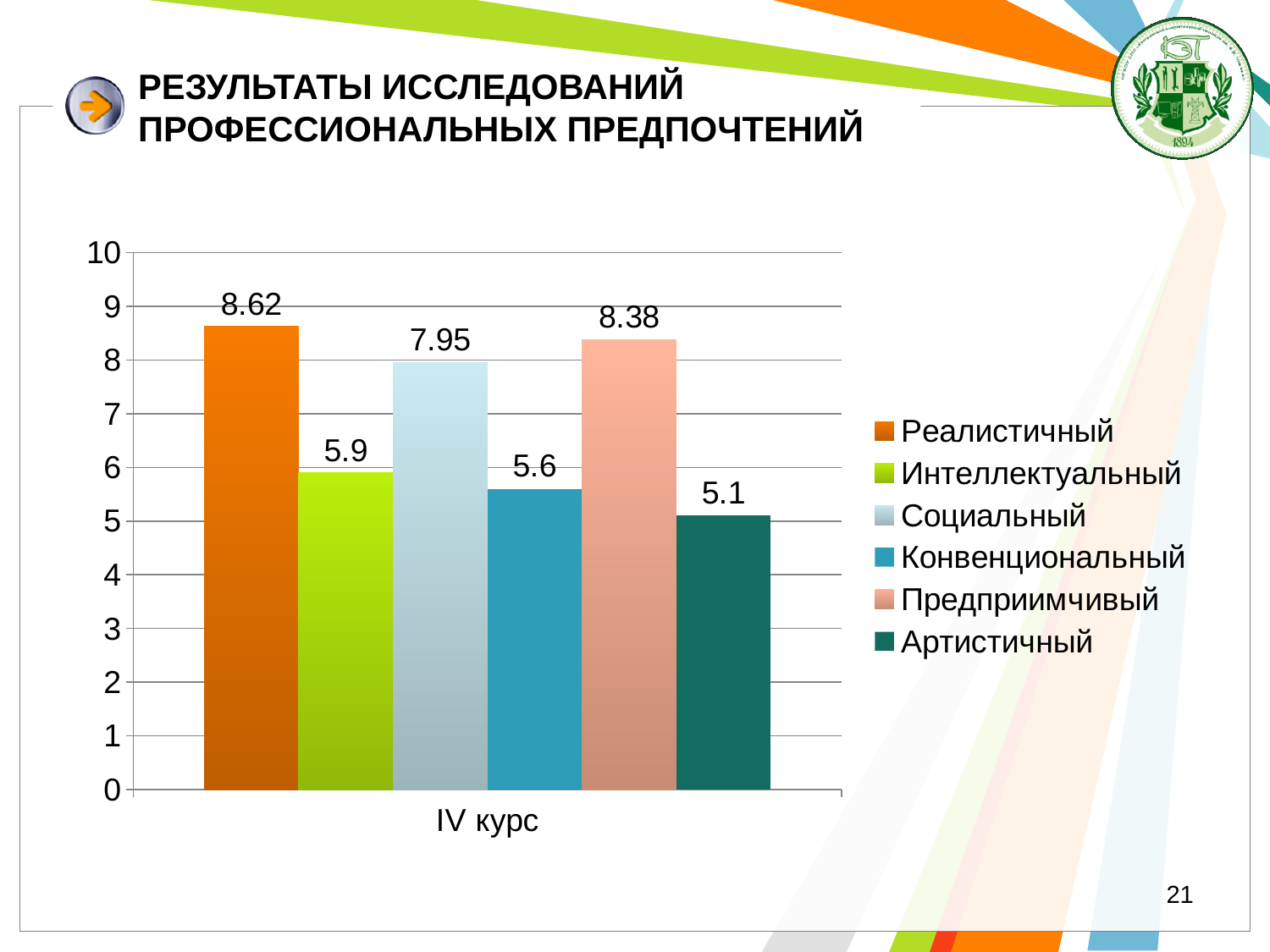
What is the value for Реалистичный? 8.62 What is the difference between the values for Реалистичный and Предприимчивый? 0.24 Which is larger, the value for Социальный or the value for Конвенциональный? Социальный Which series has the lowest value? Артистичный What is the value for Социальный? 7.95 What is the value for Артистичный? 5.1 How many series does the legend list? 6 What is the difference between the values for Интеллектуальный and Конвенциональный? 0.3 Is the value for Предприимчивый greater or less than 8? greater Which series has the highest value? Реалистичный What kind of chart is shown on the slide? bar chart What is the label on the x axis under the bars? IV курс